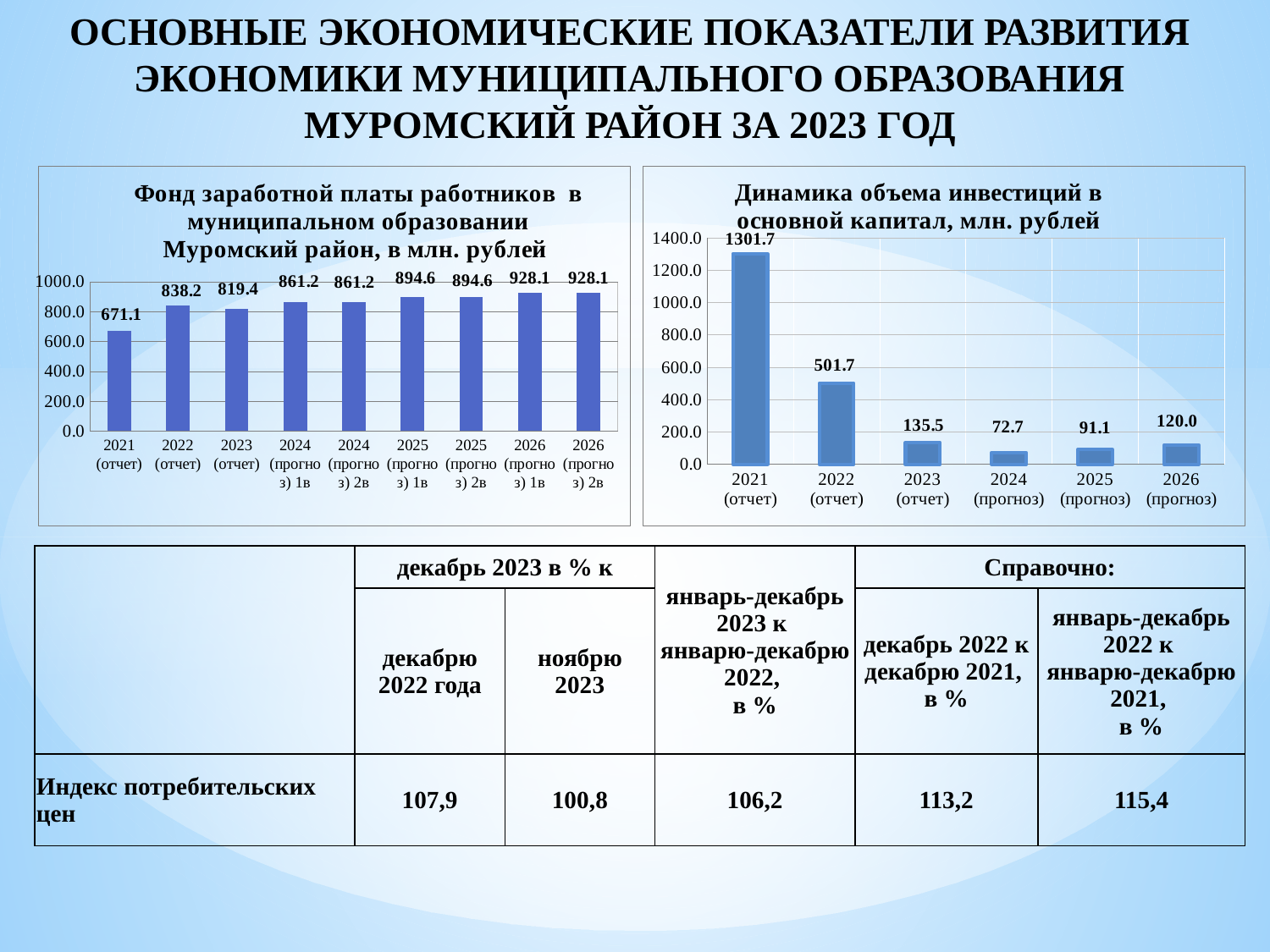
In the right chart (Динамика объема инвестиций в основной капитал), what is the value for 2022 (отчет)? 501.7 In the left chart (Фонд заработной платы работников), is the value for 2022 (отчет) greater or less than 800.0? greater In the right chart (Динамика объема инвестиций в основной капитал), what is the difference between the 2021 and 2022 values? 800.0 In the left chart (Фонд заработной платы работников), what is the value for 2023 (отчет)? 819.4 In the left chart (Фонд заработной платы работников), which category has the lowest value? 2021 (отчет) In the right chart (Динамика объема инвестиций в основной капитал), which year has the highest value? 2021 (отчет) In the left chart (Фонд заработной платы работников), what is the value for 2021 (отчет)? 671.1 In the left chart (Фонд заработной платы работников), how many bars are plotted? 9 In the right chart (Динамика объема инвестиций в основной капитал), which is larger: the value for 2025 (прогноз) or 2026 (прогноз)? 2026 (прогноз) In the right chart (Динамика объема инвестиций в основной капитал), which year has the lowest value? 2024 (прогноз) What type of chart is the right chart (Динамика объема инвестиций в основной капитал)? bar chart In the left chart (Фонд заработной платы работников), what is the difference between the 2022 (отчет) and 2021 (отчет) values? 167.1